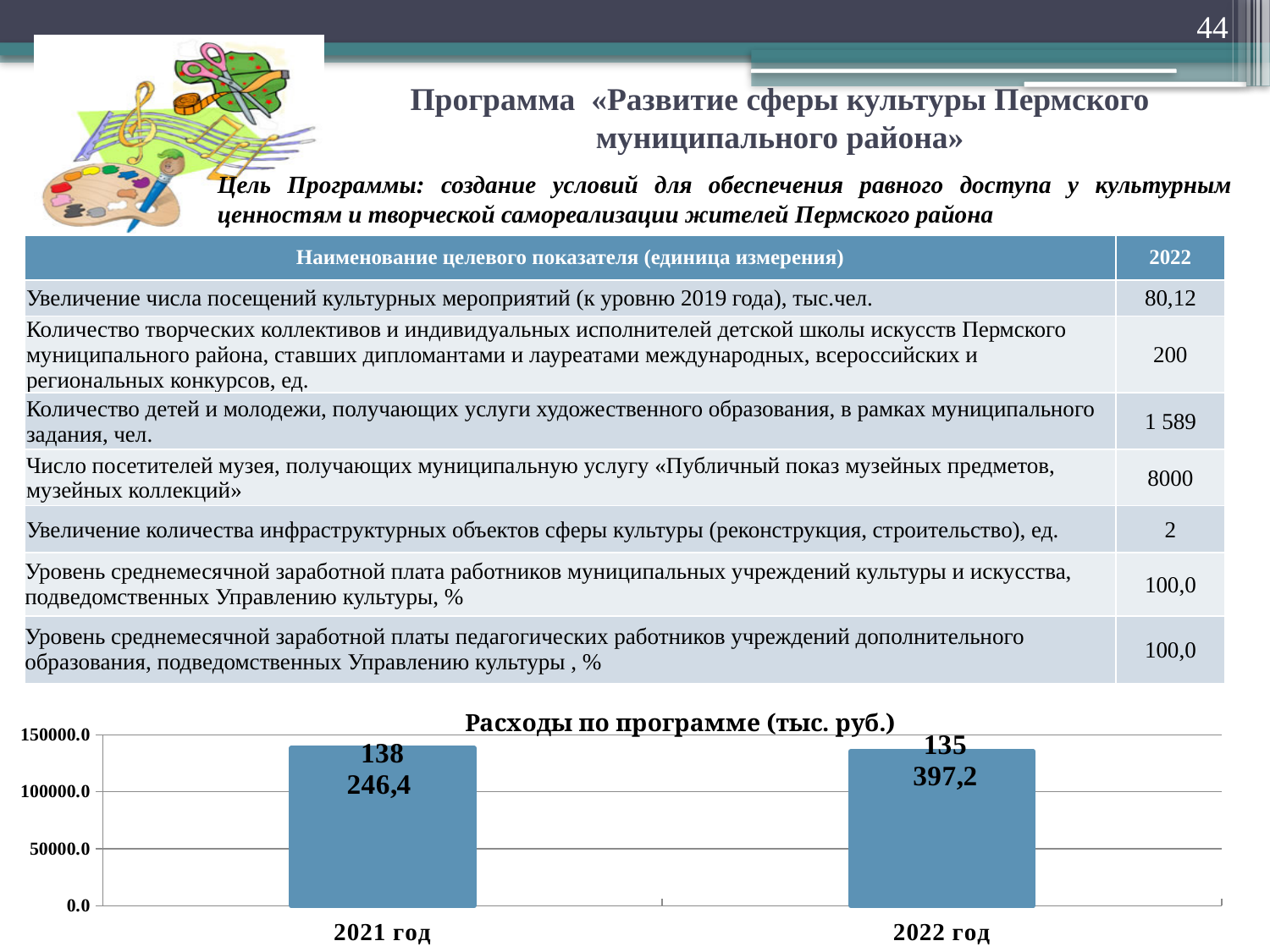
What is the title of the bar chart at the bottom of the slide? Расходы по программе (тыс. руб.) In the chart "Расходы по программе (тыс. руб.)", is the value for 2021 год larger or smaller than the value for 2022 год? larger What type of chart is shown under the title "Расходы по программе (тыс. руб.)"? bar chart In the chart "Расходы по программе (тыс. руб.)", what is the difference between the values for 2021 год and 2022 год? 2 849,2 How many bars are plotted in the chart "Расходы по программе (тыс. руб.)"? 2 In the chart "Расходы по программе (тыс. руб.)", which year has the lower value? 2022 год In the chart "Расходы по программе (тыс. руб.)", is the value for 2022 год greater or less than 100000.0? greater In the chart "Расходы по программе (тыс. руб.)", which year has the higher value? 2021 год In the chart "Расходы по программе (тыс. руб.)", what is the value for 2022 год? 135 397,2 In the chart "Расходы по программе (тыс. руб.)", do the values rise or fall from 2021 год to 2022 год? fall In the chart "Расходы по программе (тыс. руб.)", is the value for 2021 год greater or less than 150000.0? less In the chart "Расходы по программе (тыс. руб.)", what is the value for 2021 год? 138 246,4